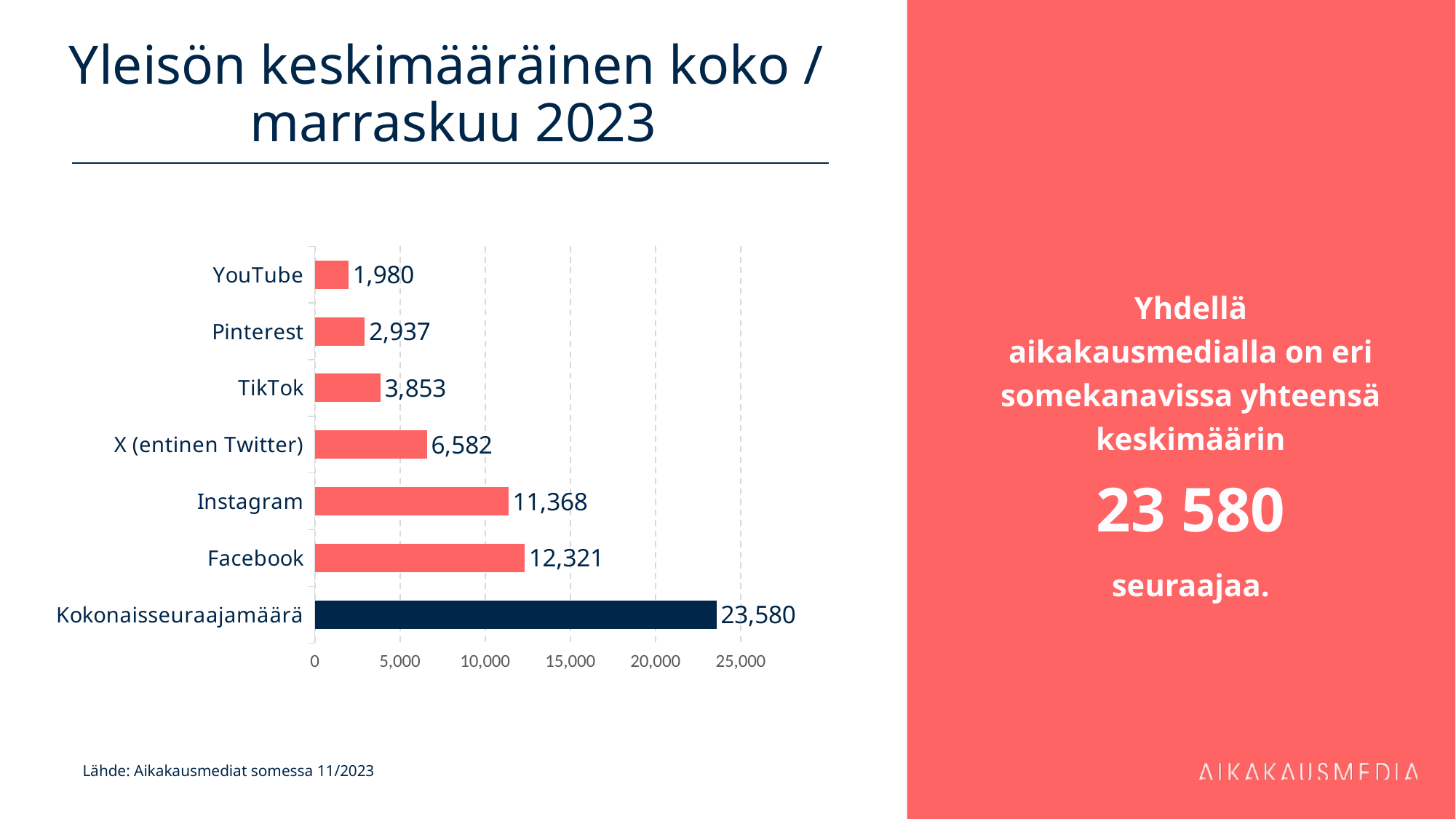
What is the value for Facebook? 12,321 Which is larger, the value for TikTok or the value for Pinterest? TikTok What is the value for X (entinen Twitter)? 6,582 Which category has the lowest value? YouTube How many categories are shown in the chart? 7 What is the value for Kokonaisseuraajamäärä? 23,580 What is the difference between the values for Facebook and Instagram? 953 What is the title of the slide? Yleisön keskimääräinen koko / marraskuu 2023 Which category has the highest value? Kokonaisseuraajamäärä What kind of chart is shown on the slide? bar chart What is the value for YouTube? 1,980 Is the value for Instagram greater or less than 10,000? greater